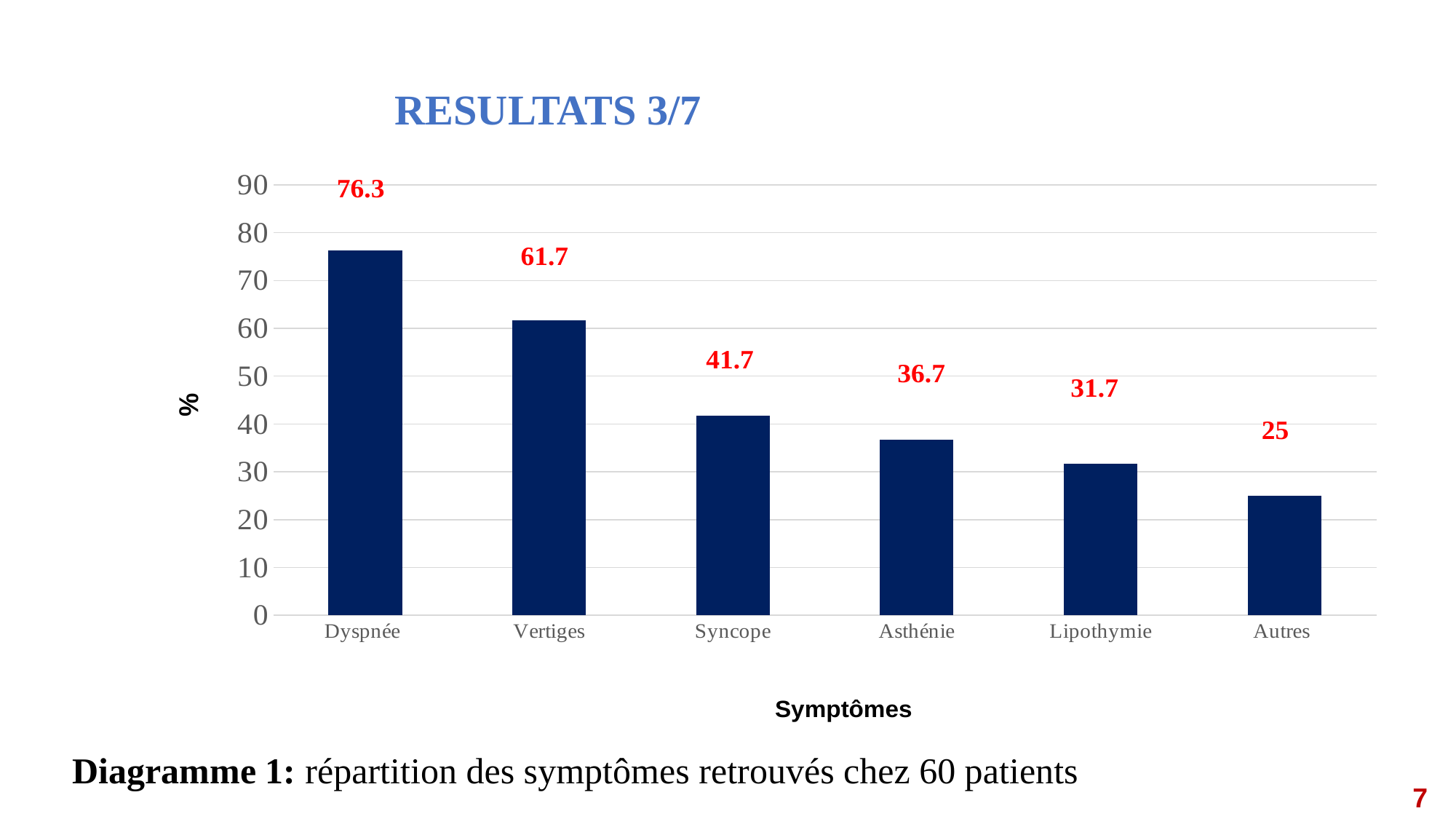
What is the difference between the values for Asthénie and Lipothymie? 5 How many symptom categories are shown on the x axis? 6 Which symptom has the highest value? Dyspnée Is the value for Vertiges greater or less than 60? greater Which symptom has the lowest value? Autres What is the value for Dyspnée? 76.3 What is the label of the x axis? Symptômes What is the value for Syncope? 41.7 What kind of chart is shown on the slide? bar chart Which is larger, the value for Syncope or the value for Asthénie? Syncope What is the value for Autres? 25 What is the difference between the values for Dyspnée and Vertiges? 14.6